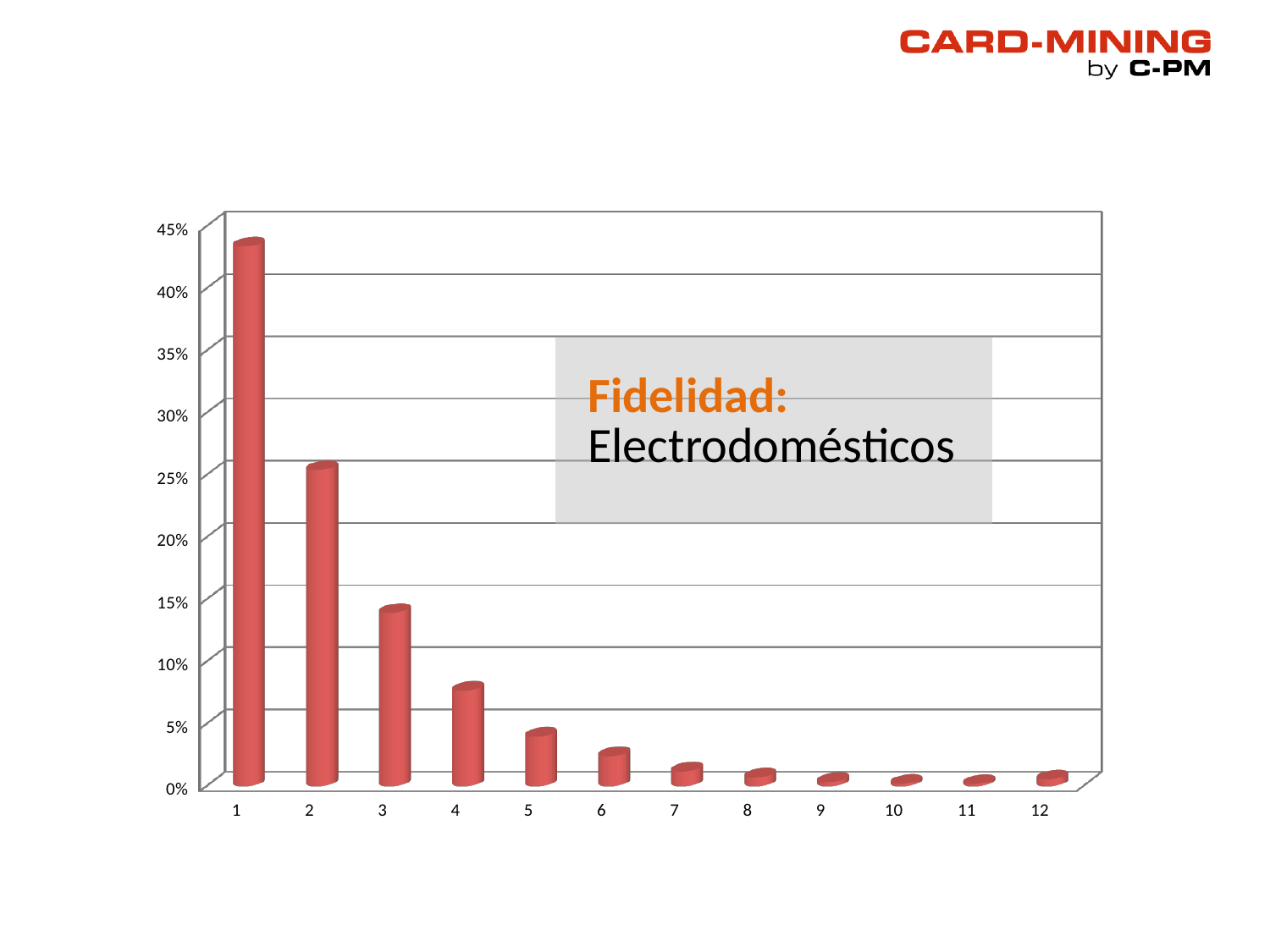
Is the value for category 2 greater or less than 20%? greater Is the value for category 2 greater or less than 30%? less How many categories are plotted along the x axis? 12 Do the values rise or fall as you move from category 1 to category 12? Fall Is the value for category 5 greater or less than 5%? less Which is larger, the value for category 1 or the value for category 2? Category 1 Which category has the highest value? 1 What kind of chart is shown on the slide? Bar chart What text is shown in the grey box overlaid on the chart? Fidelidad: Electrodomésticos